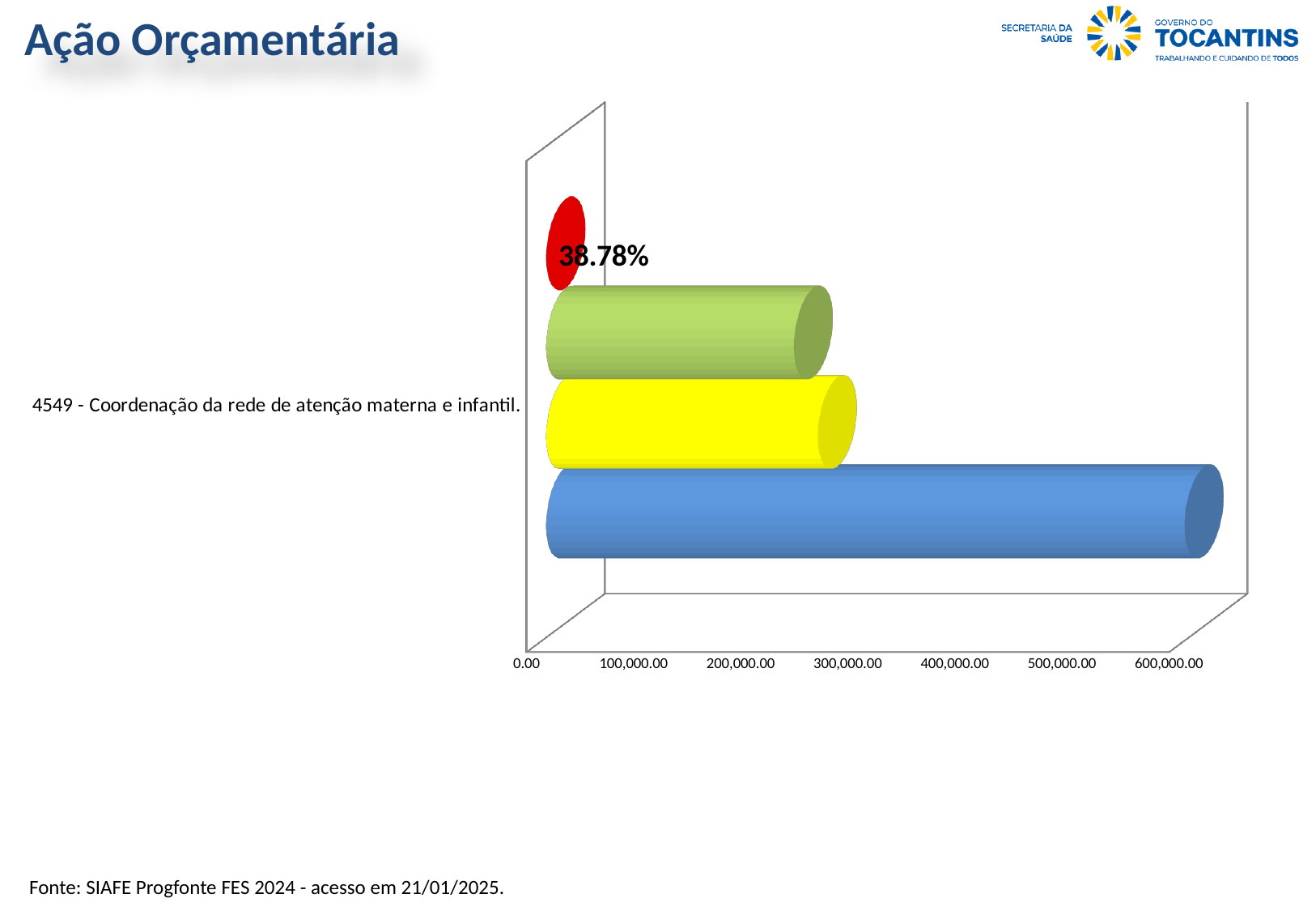
Which coloured bar is the shortest in the chart? red What kind of chart is shown on the slide? bar chart Is the value of the yellow bar greater or less than 200,000.00? greater What is the category label shown on the chart? 4549 - Coordenação da rede de atenção materna e infantil. What is the title of the slide containing the chart? Ação Orçamentária Which is larger, the blue bar or the yellow bar? blue bar Is the value of the red bar greater or less than 100,000.00? less Is the value of the green bar greater or less than 400,000.00? less Which coloured bar is the longest in the chart? blue What percentage is printed as a data label on the chart? 38.78% How many categories does the chart show? 1